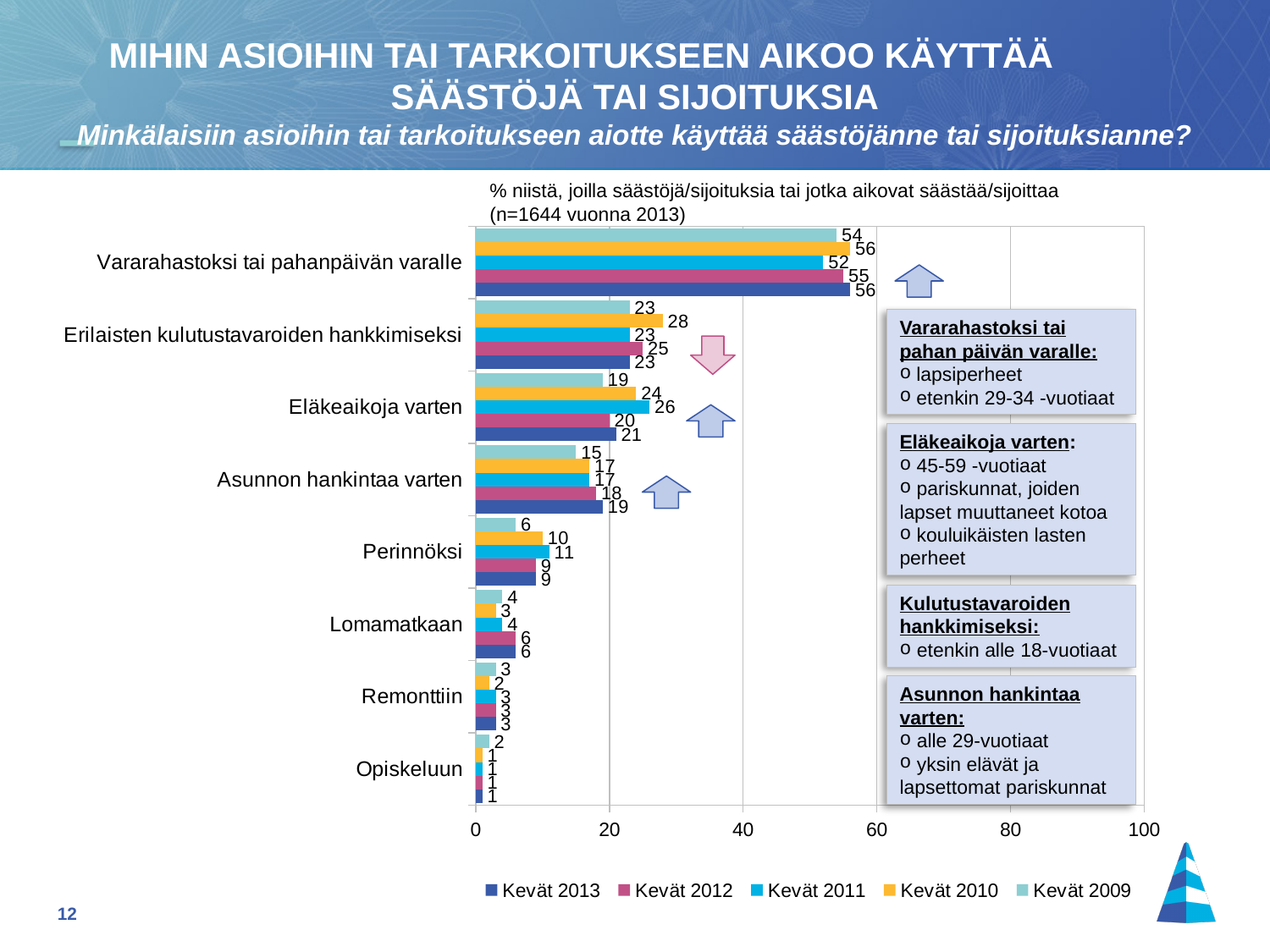
What kind of chart is shown on the slide? bar chart Which is larger for Perinnöksi: the Kevät 2011 value or the Kevät 2009 value? Kevät 2011 Is the Kevät 2012 value for Vararahastoksi tai pahanpäivän varalle greater or less than 40? greater What is the Kevät 2013 value for Vararahastoksi tai pahanpäivän varalle? 56 Which series is listed first in the legend? Kevät 2013 What is the Kevät 2011 value for Eläkeaikoja varten? 26 Which category has the highest Kevät 2013 value? Vararahastoksi tai pahanpäivän varalle What is the Kevät 2010 value for Erilaisten kulutustavaroiden hankkimiseksi? 28 How many series does the legend list? 5 How many categories are shown on the chart? 8 Which category has the lowest Kevät 2013 value? Opiskeluun What is the difference between the Kevät 2013 and Kevät 2009 values for Asunnon hankintaa varten? 4